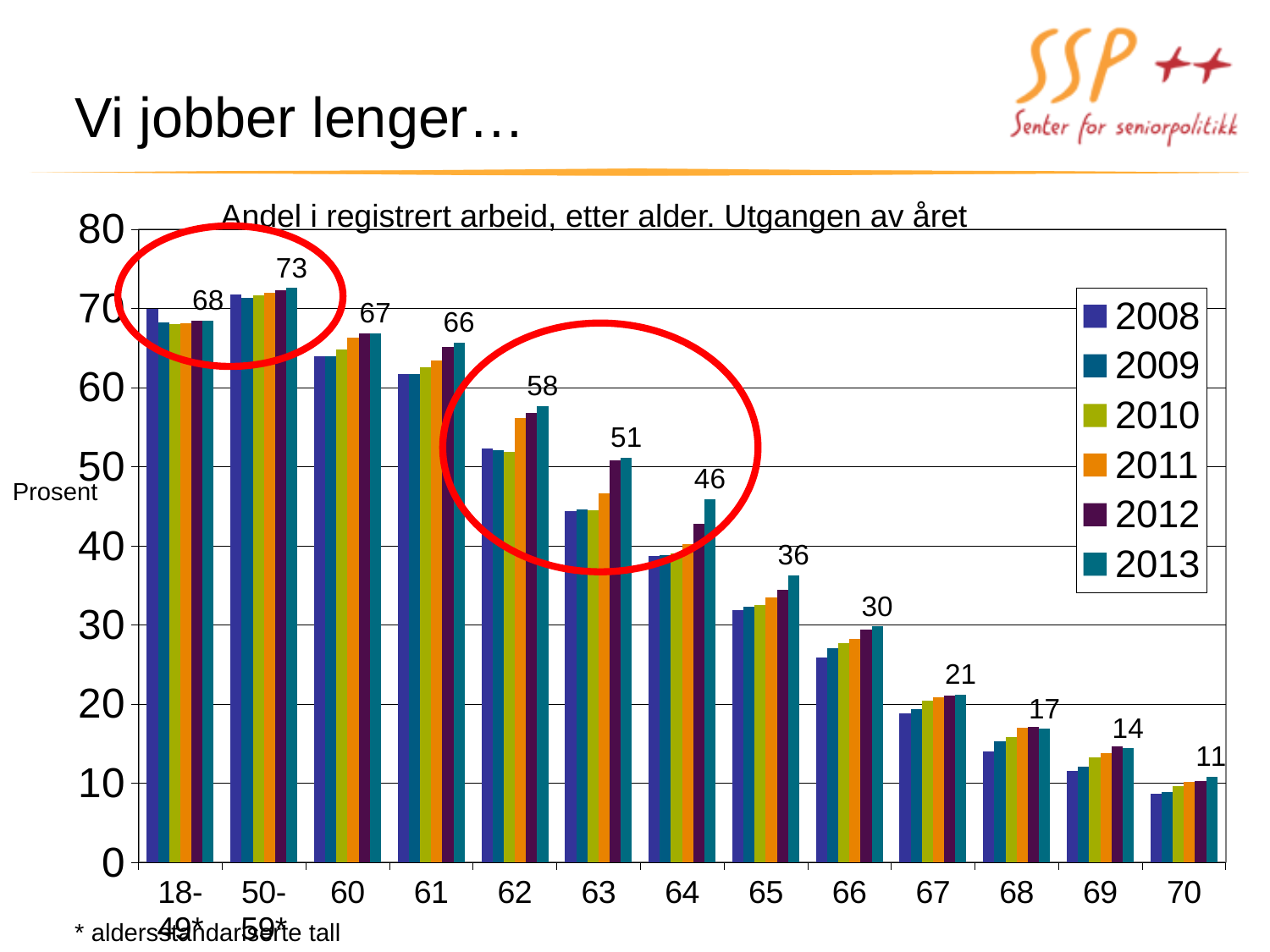
What is the 2013 value for the 70 age group? 11 Do the 2013 values rise or fall as age increases from 60 to 70? Fall What is the 2013 value for the 62 age group? 58 Is the 2008 value for the 66 age group greater or less than 20? greater What kind of chart is shown on the slide? Bar chart Which age group has the lowest 2013 value? 70 What is the difference between the 2013 values for the 63 and 64 age groups? 5 How many age groups are shown on the x axis? 13 What is the difference between the 2013 values for the 50-59* and 18-49* age groups? 5 Which age group has the highest 2013 value? 50-59* How many series does the legend list? 6 Which has the larger 2013 value, the 65 age group or the 66 age group? 65